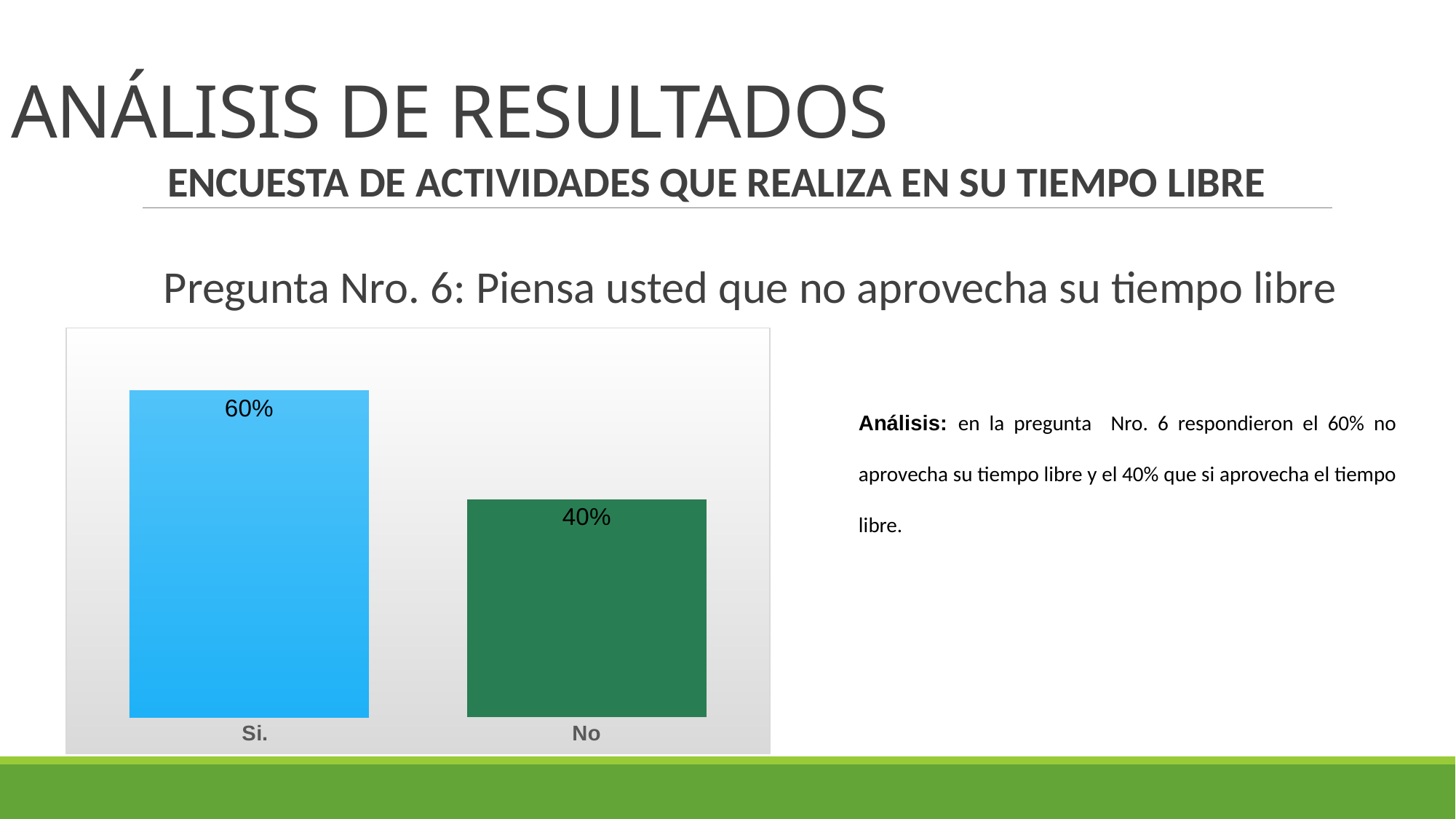
What is the total of the two bar values? 100% How many categories are shown in the chart? 2 Which category has the lowest value? No Which category has the highest value? Si. What is the difference between the values for "Si." and "No"? 20% What is the value for "No"? 40% Which is larger, the value for "Si." or the value for "No"? Si. What colour is the bar for "No"? Green Do the values rise or fall from left to right along the x axis? Fall What is the value for "Si."? 60% What colour is the bar for "Si."? Blue What kind of chart is shown on the slide? Bar chart